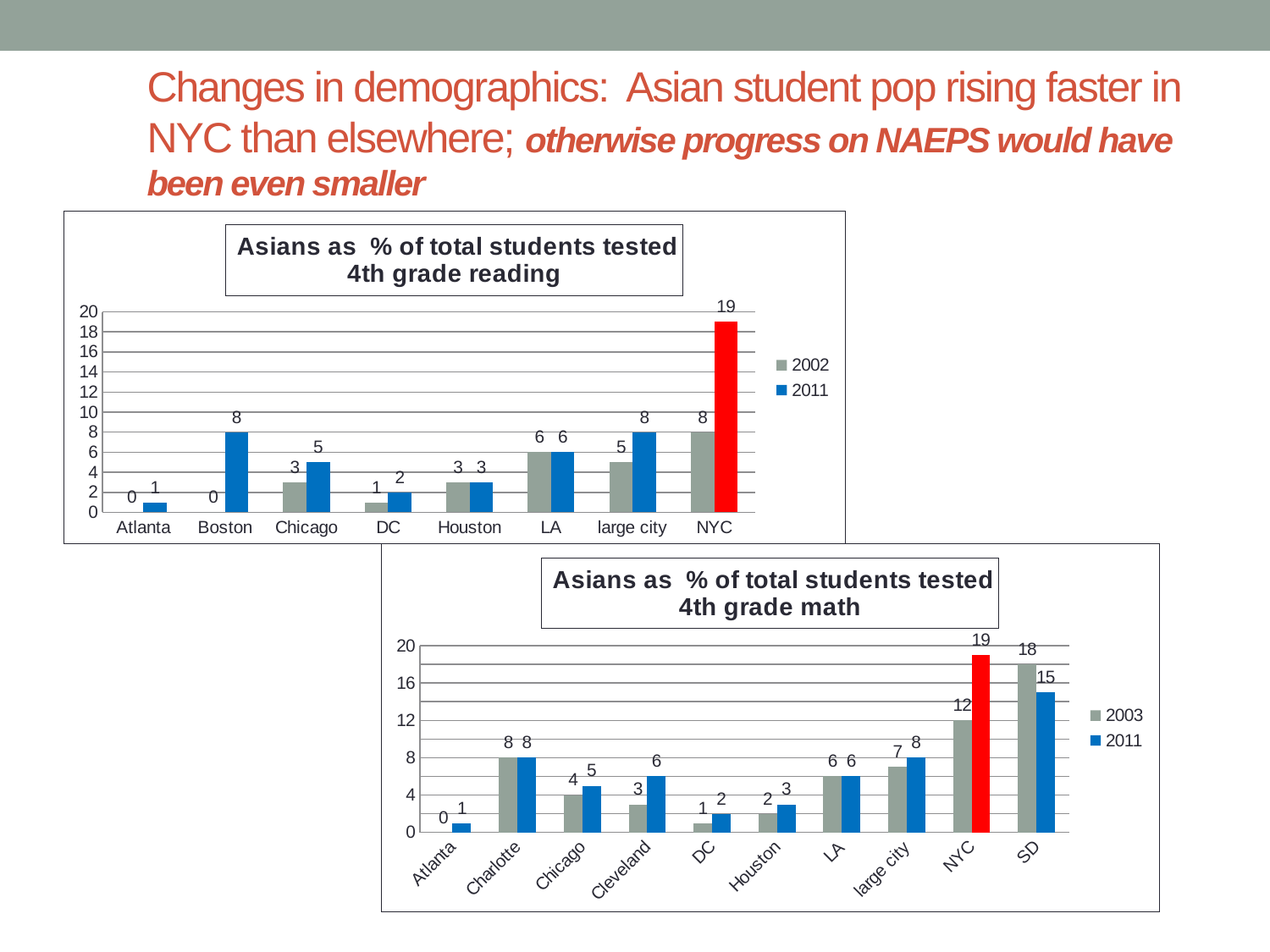
In the 4th grade reading chart, how many series does the legend list? 2 In the 4th grade reading chart, which city has the highest value in 2011? NYC In the 4th grade math chart, what is the value for SD in 2003? 18 In the 4th grade reading chart, how many categories are shown on the x axis? 8 In the 4th grade math chart, what is the difference between the 2011 and 2003 values for NYC? 7 In the 4th grade math chart, what is the value for Cleveland in 2011? 6 In the 4th grade math chart, how many categories are shown on the x axis? 10 In the 4th grade reading chart, what is the difference between the 2011 and 2002 values for NYC? 11 In the 4th grade math chart, which is larger for SD: the 2003 value or the 2011 value? 2003 In the 4th grade reading chart, what is the value for Boston in 2002? 0 In the 4th grade reading chart, what is the value for NYC in 2011? 19 What type of chart is the 4th grade math chart? Bar chart